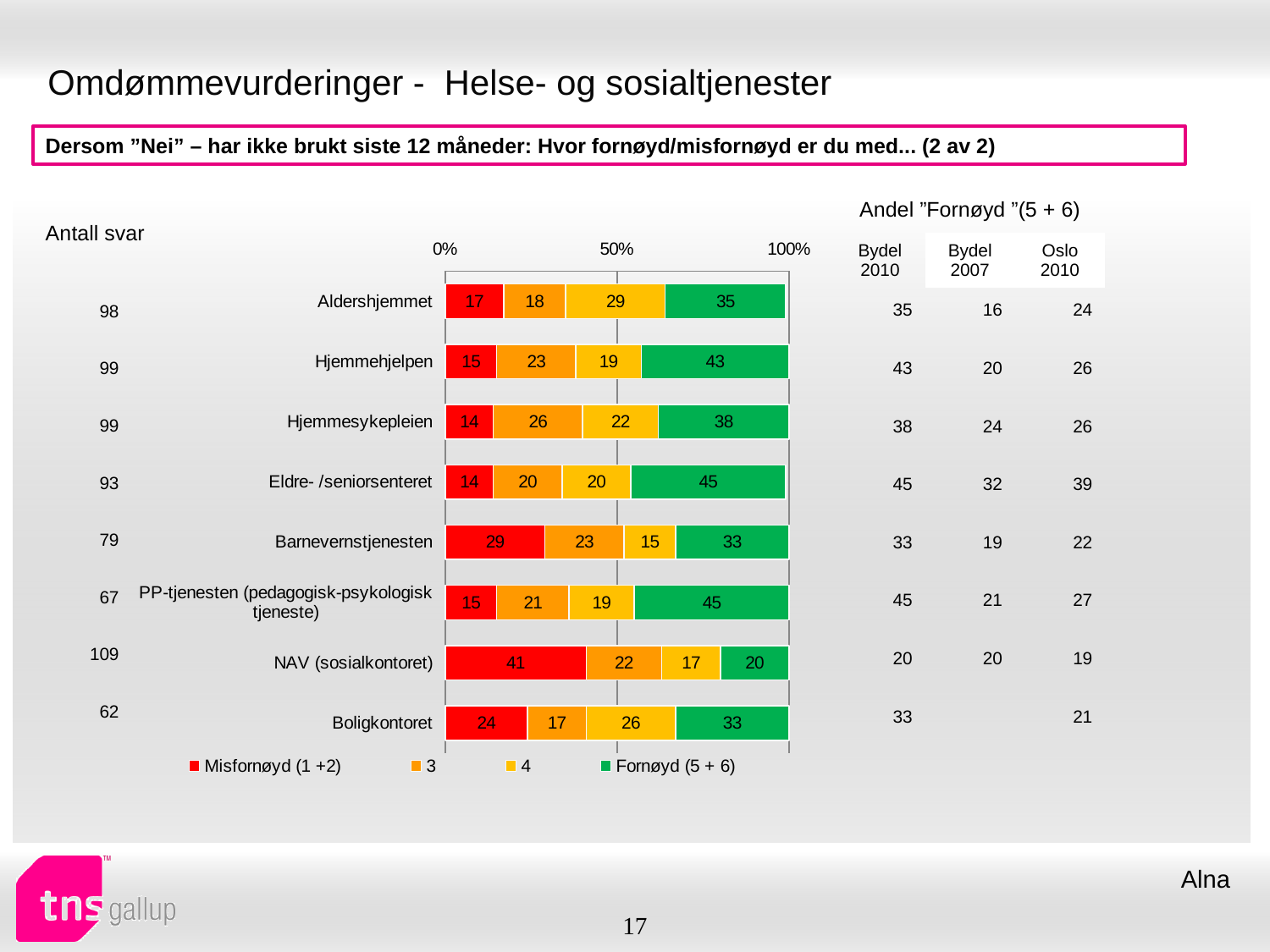
What is the value of "Fornøyd (5 + 6)" for Hjemmehjelpen? 43 Which category has the highest "Misfornøyd (1 +2)" value? NAV (sosialkontoret) Which category has the lowest "Fornøyd (5 + 6)" value? NAV (sosialkontoret) What is the value of series "4" for Boligkontoret? 26 What is the value of "Misfornøyd (1 +2)" for NAV (sosialkontoret)? 41 What kind of chart is shown on the slide? Stacked bar chart What is the value of series "3" for Hjemmesykepleien? 26 How many categories are shown in the chart? 8 What is the total of the stacked bar for Boligkontoret? 100 How many series does the legend list? 4 What is the difference between the "Misfornøyd (1 +2)" and "Fornøyd (5 + 6)" values for NAV (sosialkontoret)? 21 Which has a larger "Fornøyd (5 + 6)" value, Aldershjemmet or Hjemmehjelpen? Hjemmehjelpen